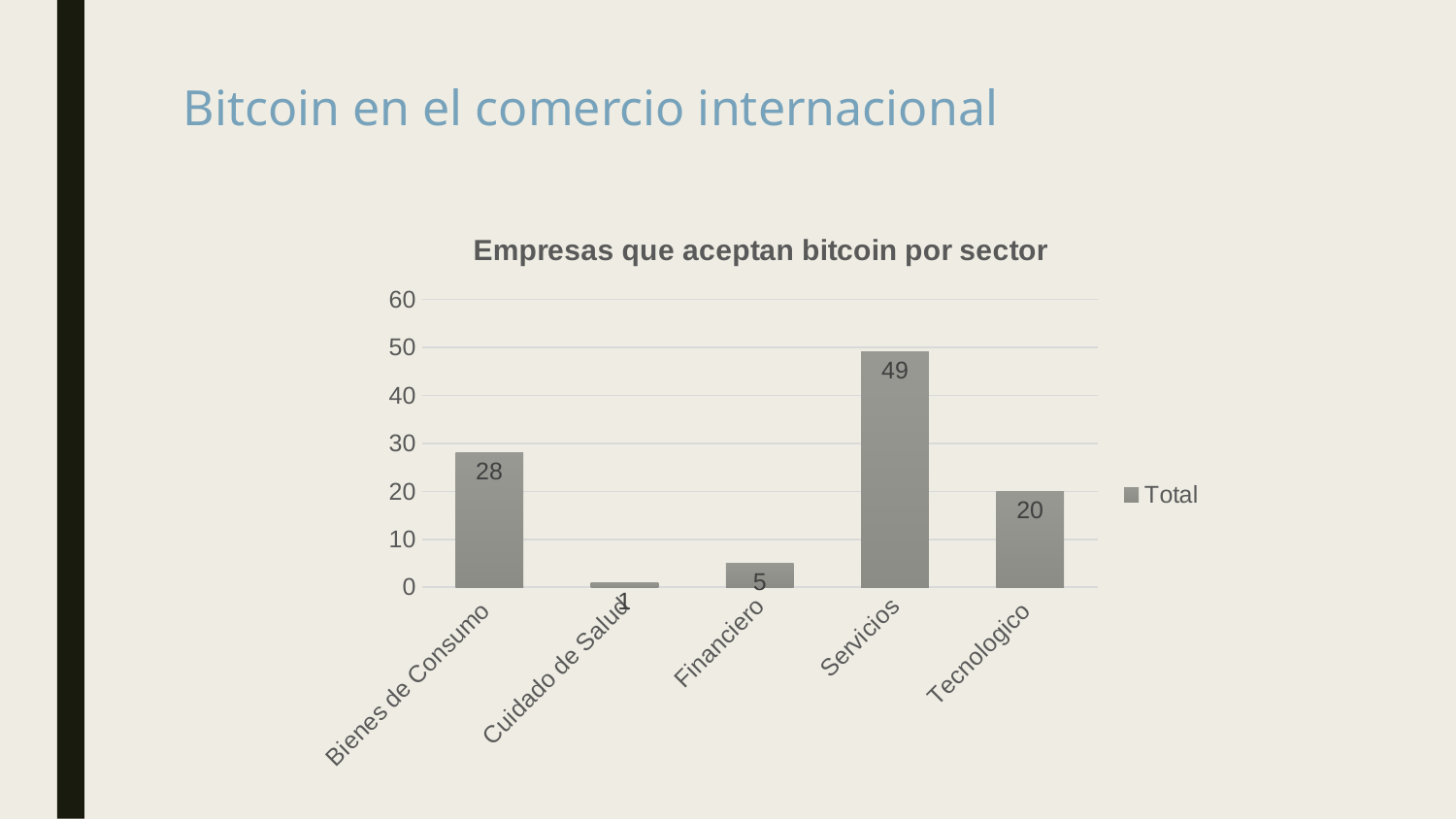
What is the value for Bienes de Consumo? 28 What is the difference between the values for Servicios and Bienes de Consumo? 21 Which sector has the highest value? Servicios What is the value for Servicios? 49 What type of chart is shown? bar chart What is the value for Financiero? 5 Is the value for Cuidado de Salud greater or less than 10? less Which is larger, the value for Tecnologico or the value for Financiero? Tecnologico What is the title of the chart? Empresas que aceptan bitcoin por sector Which sector has the lowest value? Cuidado de Salud How many sectors are shown on the x axis? 5 What is the value for Tecnologico? 20